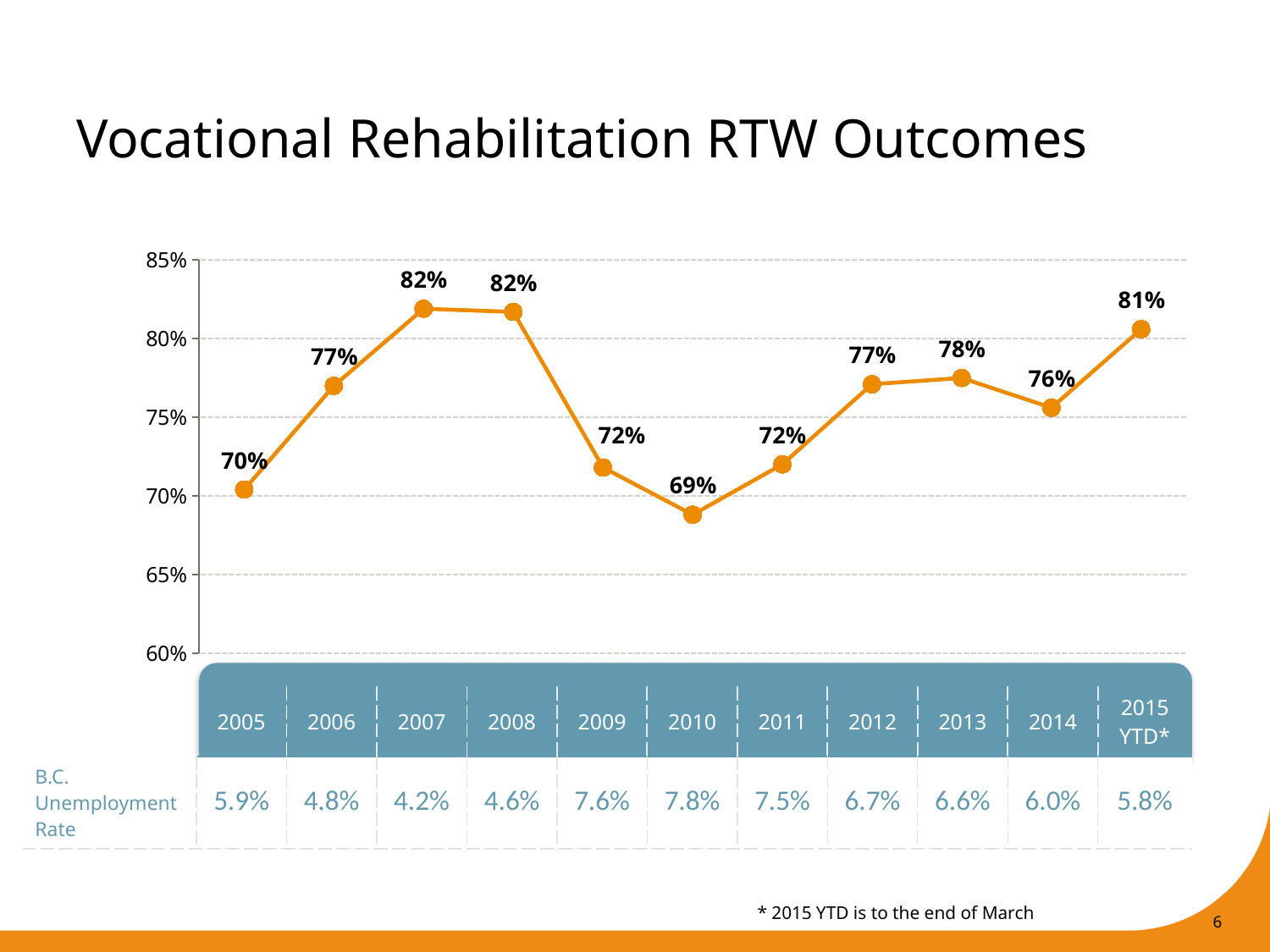
What is the difference between the RTW outcome values for 2015 YTD and 2014? 5 percentage points What is the difference between the RTW outcome values for 2007 and 2005? 12 percentage points What is the RTW outcome value for 2005? 70% Do the RTW outcome values rise or fall from 2008 to 2010? Fall Which year has the lowest RTW outcome value? 2010 What is the RTW outcome value for 2013? 78% Is the RTW outcome value for 2010 greater or less than 70%? less What is the highest RTW outcome value shown on the chart? 82% How many data points are plotted on the line chart? 11 What is the RTW outcome value for 2015 YTD? 81% Which year has the larger RTW outcome value, 2012 or 2009? 2012 What kind of chart is shown on the slide? Line chart